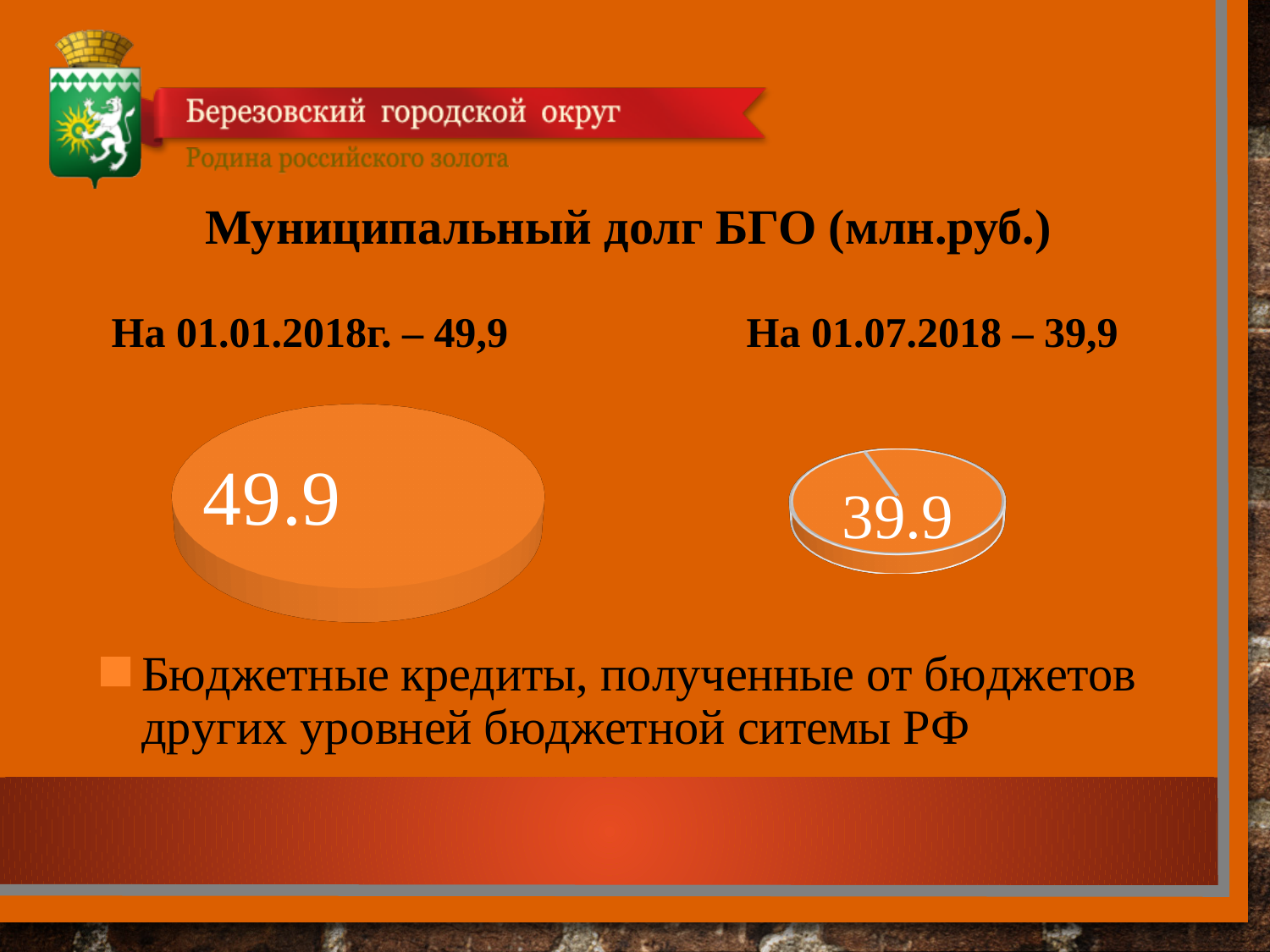
What share of the left pie chart (as of 01.01.2018) does its single slice occupy? 100% What does the legend entry below the pie charts say? Бюджетные кредиты, полученные от бюджетов других уровней бюджетной ситемы РФ On the right pie chart (as of 01.07.2018), what value is printed on the slice? 39.9 How many slices does the right pie chart (as of 01.07.2018) contain? 1 Which pie chart shows the larger value, the one for 01.01.2018 or the one for 01.07.2018? 01.01.2018 What kind of chart is used on the left of the slide to show the municipal debt as of 01.01.2018? pie chart What is the title above the two pie charts? Муниципальный долг БГО (млн.руб.) How many slices does the left pie chart (as of 01.01.2018) contain? 1 How many entries does the legend below the pie charts list? 1 Did the municipal debt rise or fall from 01.01.2018 to 01.07.2018 according to the two pie charts? fall On the left pie chart (as of 01.01.2018), what value is printed on the slice? 49.9 What is the difference between the value on the left pie chart (49.9) and the value on the right pie chart (39.9)? 10